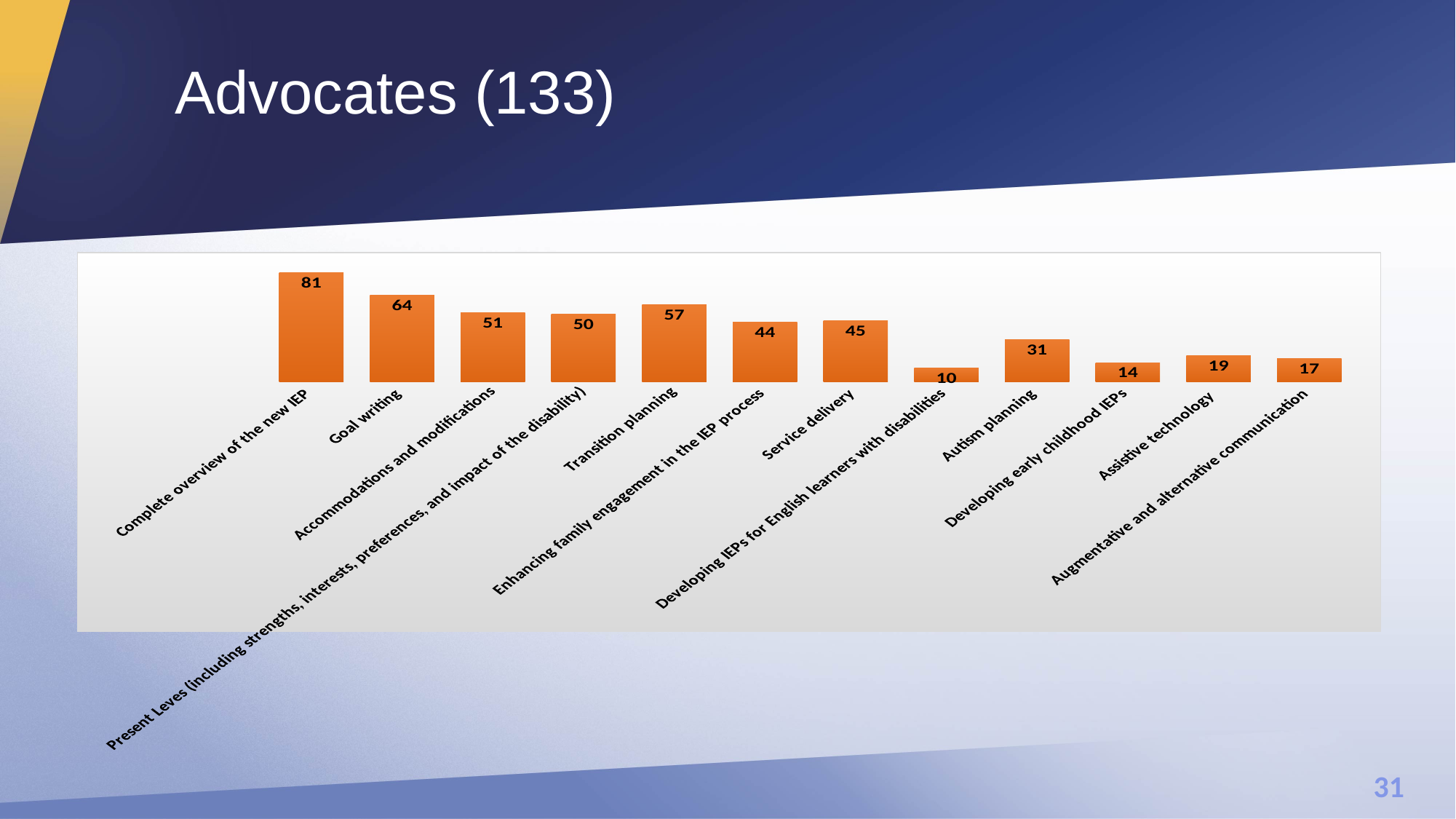
What is the value for Transition planning? 57 What is the value for Assistive technology? 19 What is the difference between the values for Service delivery and Developing early childhood IEPs? 31 How many categories are shown in the chart? 12 Which is larger, the value for Transition planning or the value for Accommodations and modifications? Transition planning Which category has the highest value? Complete overview of the new IEP What is the value for Autism planning? 31 What kind of chart is shown on the slide? Bar chart What is the value for Goal writing? 64 What is the difference between the values for Complete overview of the new IEP and Goal writing? 17 Which category has the lowest value? Developing IEPs for English learners with disabilities What is the title of the slide containing the chart? Advocates (133)